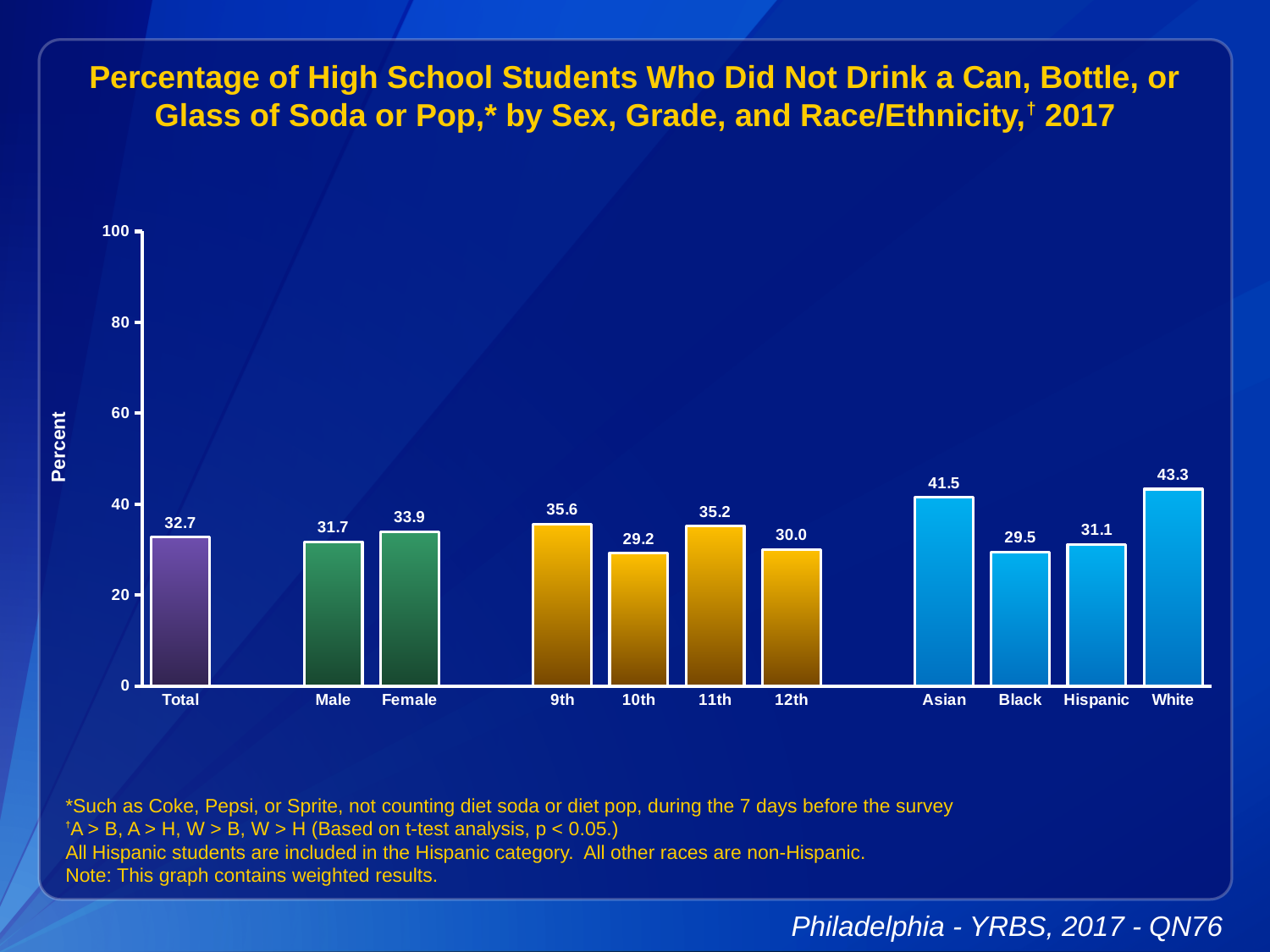
What is the value for Total? 32.7 Is the value for White greater or less than 40? greater What is the difference between the values for Female and Male? 2.2 Which category has the highest value? White What is the value for Female? 33.9 Which category has the lowest value? 10th How many bars are shown in the chart? 11 What is the label of the y axis? Percent What is the value for 10th grade? 29.2 What kind of chart is shown? bar chart Which is larger, the value for 9th grade or 12th grade? 9th What is the value for Asian students? 41.5